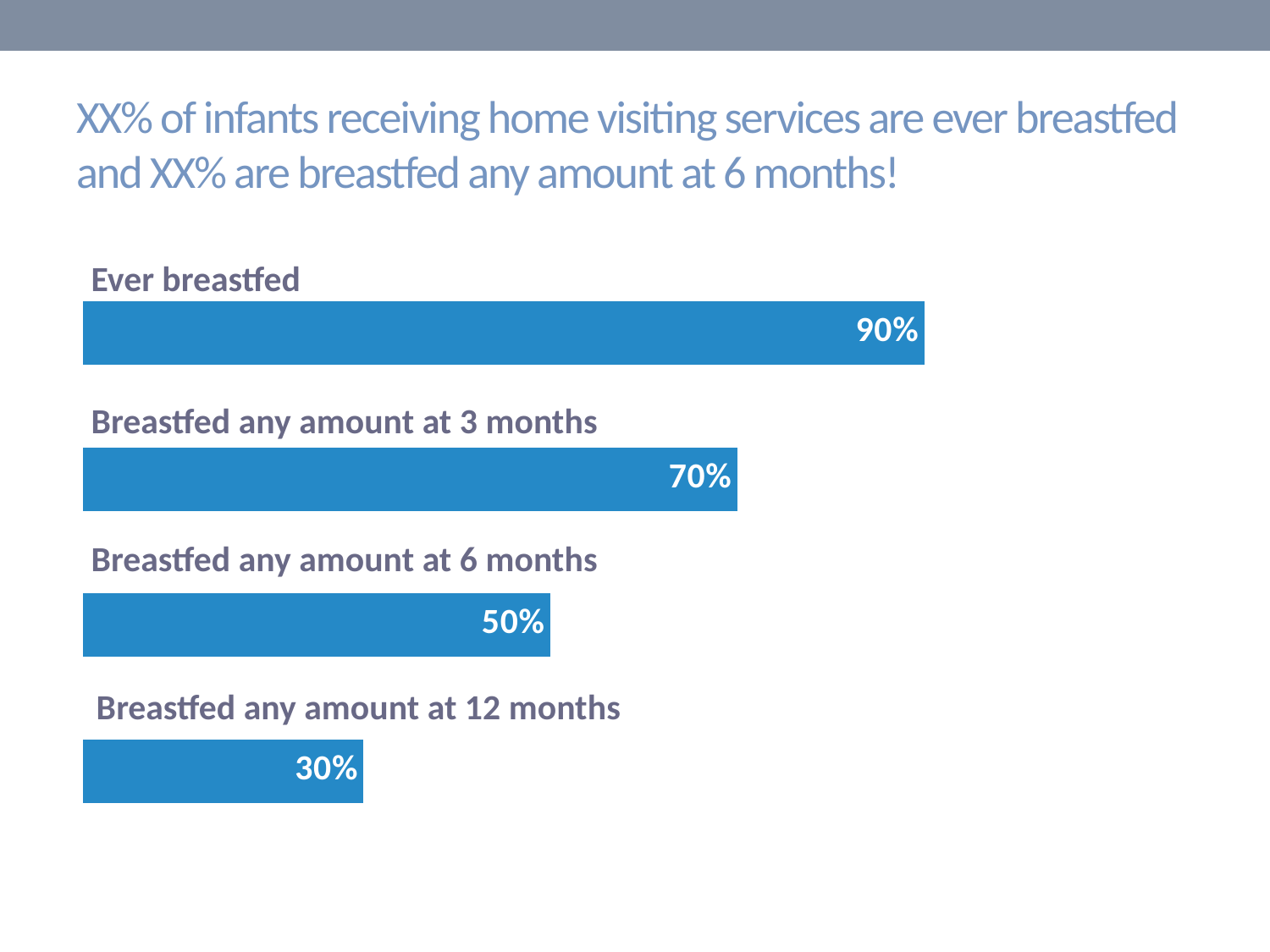
How many categories are shown in the chart? 4 What is the value for Breastfed any amount at 3 months? 70% What is the value for Breastfed any amount at 12 months? 30% Which category has the highest value? Ever breastfed What kind of chart is shown on the slide? Bar chart What is the difference between the value for Breastfed any amount at 3 months and the value for Breastfed any amount at 12 months? 40% What is the value for Breastfed any amount at 6 months? 50% What is the difference between the value for Ever breastfed and the value for Breastfed any amount at 6 months? 40% What is the value for Ever breastfed? 90% Which is larger, the value for Breastfed any amount at 3 months or the value for Breastfed any amount at 6 months? Breastfed any amount at 3 months Which category has the lowest value? Breastfed any amount at 12 months Do the values rise or fall going from Ever breastfed down to Breastfed any amount at 12 months? Fall